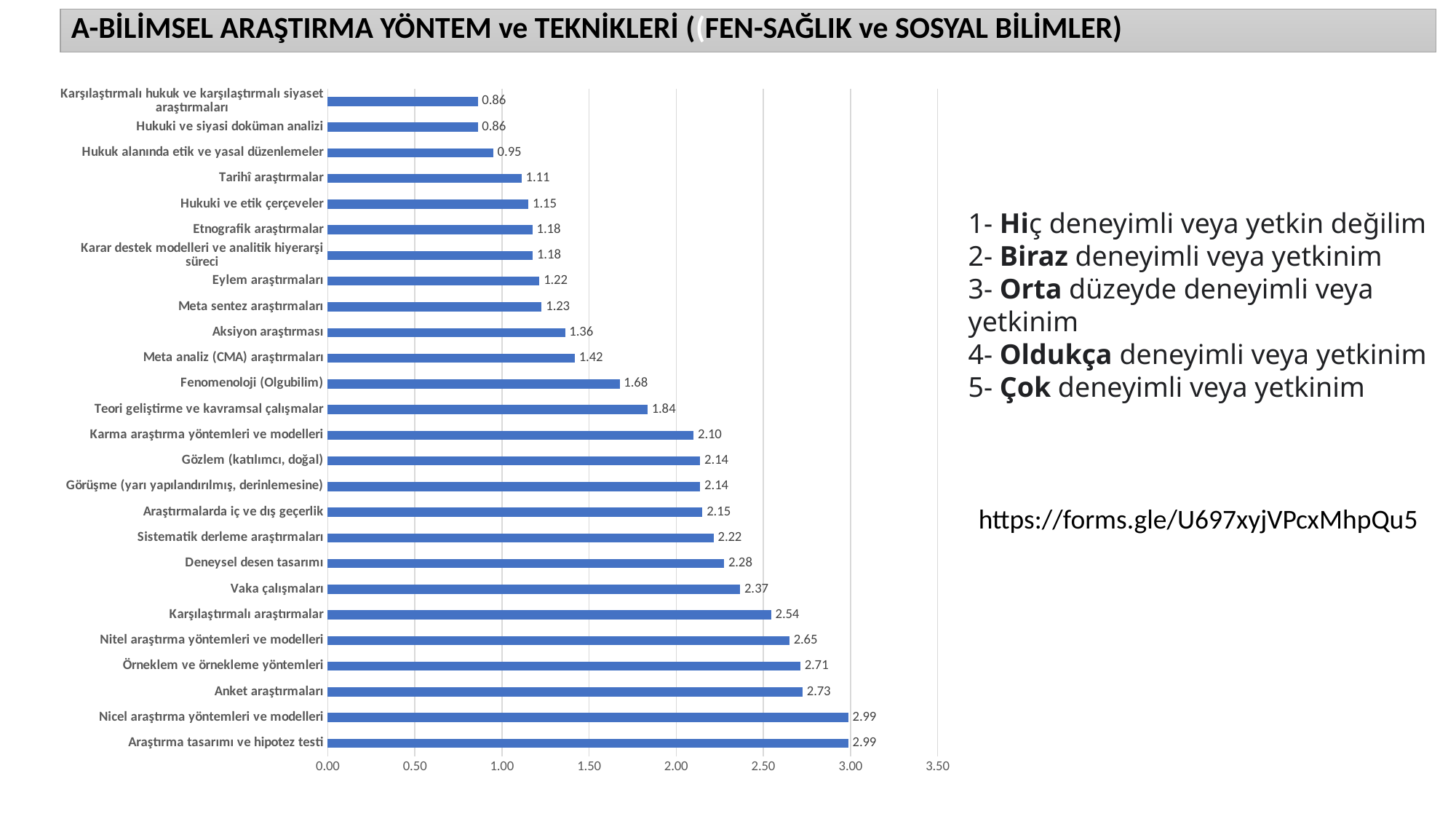
What is the value for Vaka çalışmaları? 2.37 What is the value for Anket araştırmaları? 2.73 What is the maximum value shown on the horizontal axis? 3.50 How many categories are plotted in the chart? 26 What type of chart is shown on the slide? bar chart Is the value for Meta analiz (CMA) araştırmaları greater or less than 1.50? less What is the value for Tarihî araştırmalar? 1.11 What is the highest value shown in the chart? 2.99 What is the difference between the values for Nitel araştırma yöntemleri ve modelleri and Karma araştırma yöntemleri ve modelleri? 0.55 What is the value for Fenomenoloji (Olgubilim)? 1.68 What is the lowest value shown in the chart? 0.86 Which has a larger value, Deneysel desen tasarımı or Sistematik derleme araştırmaları? Deneysel desen tasarımı